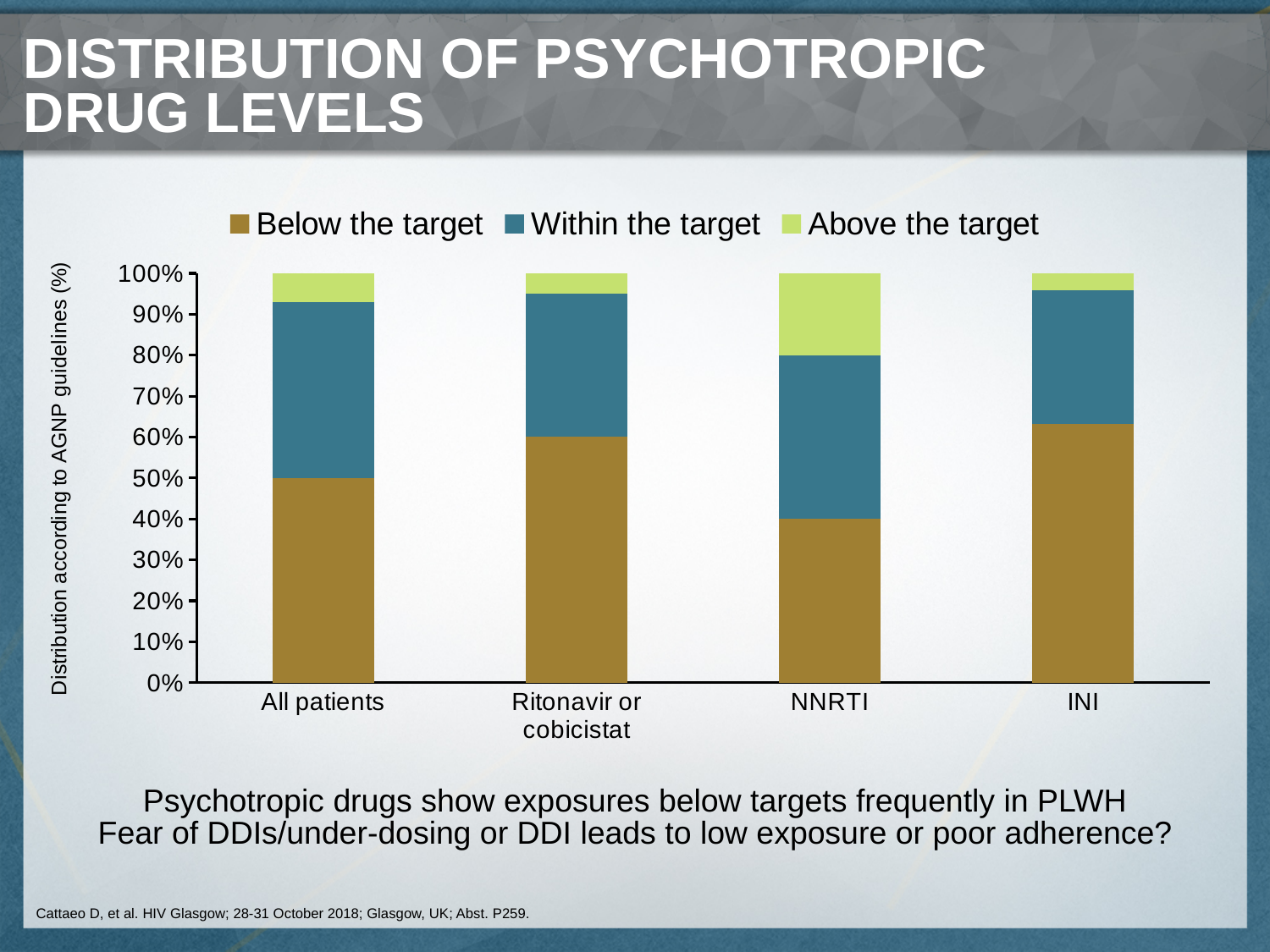
What is the 'Below the target' value for NNRTI? 40% Which category has the largest 'Above the target' share? NNRTI What is the y-axis label of the chart? Distribution according to AGNP guidelines (%) Which category has the lowest 'Below the target' share? NNRTI Which is larger, the 'Above the target' share for NNRTI or for All patients? NNRTI How many series does the legend list? 3 What is the 'Below the target' value for Ritonavir or cobicistat? 60% What kind of chart is shown on the slide? Stacked bar chart How many categories are shown on the x axis of the chart? 4 What are the three series listed in the legend? Below the target, Within the target, Above the target Is the 'Below the target' value for INI greater or less than 50%? greater What is the 'Below the target' value for All patients? 50%